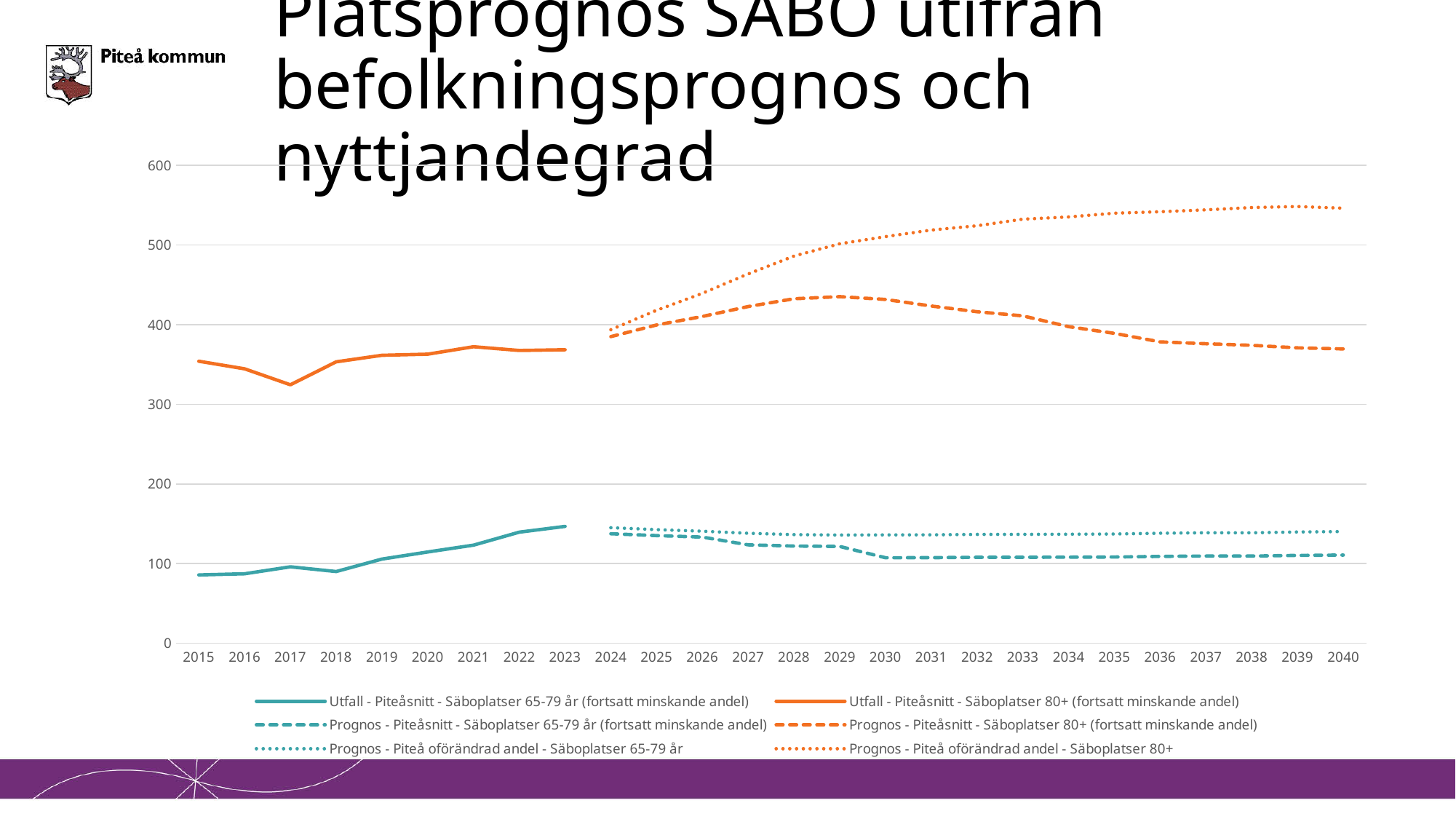
Is the value for 'Prognos - Piteå oförändrad andel - Säboplatser 80+' in 2040 greater or less than 500? greater In 2040, which is higher: 'Prognos - Piteå oförändrad andel - Säboplatser 80+' or 'Prognos - Piteåsnitt - Säboplatser 80+ (fortsatt minskande andel)'? Prognos - Piteå oförändrad andel - Säboplatser 80+ What line style is used for the 'Prognos - Piteå oförändrad andel' series in the legend? Dotted In 2030, which is higher: 'Prognos - Piteå oförändrad andel - Säboplatser 65-79 år' or 'Prognos - Piteåsnitt - Säboplatser 65-79 år (fortsatt minskande andel)'? Prognos - Piteå oförändrad andel - Säboplatser 65-79 år Does the 'Utfall - Piteåsnitt - Säboplatser 65-79 år (fortsatt minskande andel)' series generally rise or fall from 2015 to 2023? Rise How many years are shown along the x axis? 26 Is the value for 'Utfall - Piteåsnitt - Säboplatser 80+ (fortsatt minskande andel)' in 2023 greater or less than 400? less Is the value for 'Prognos - Piteåsnitt - Säboplatser 80+ (fortsatt minskande andel)' in 2029 greater or less than 400? greater What kind of chart is shown on the slide? Line chart How many series does the legend list? 6 In which year is the 'Utfall - Piteåsnitt - Säboplatser 80+ (fortsatt minskande andel)' series at its lowest? 2017